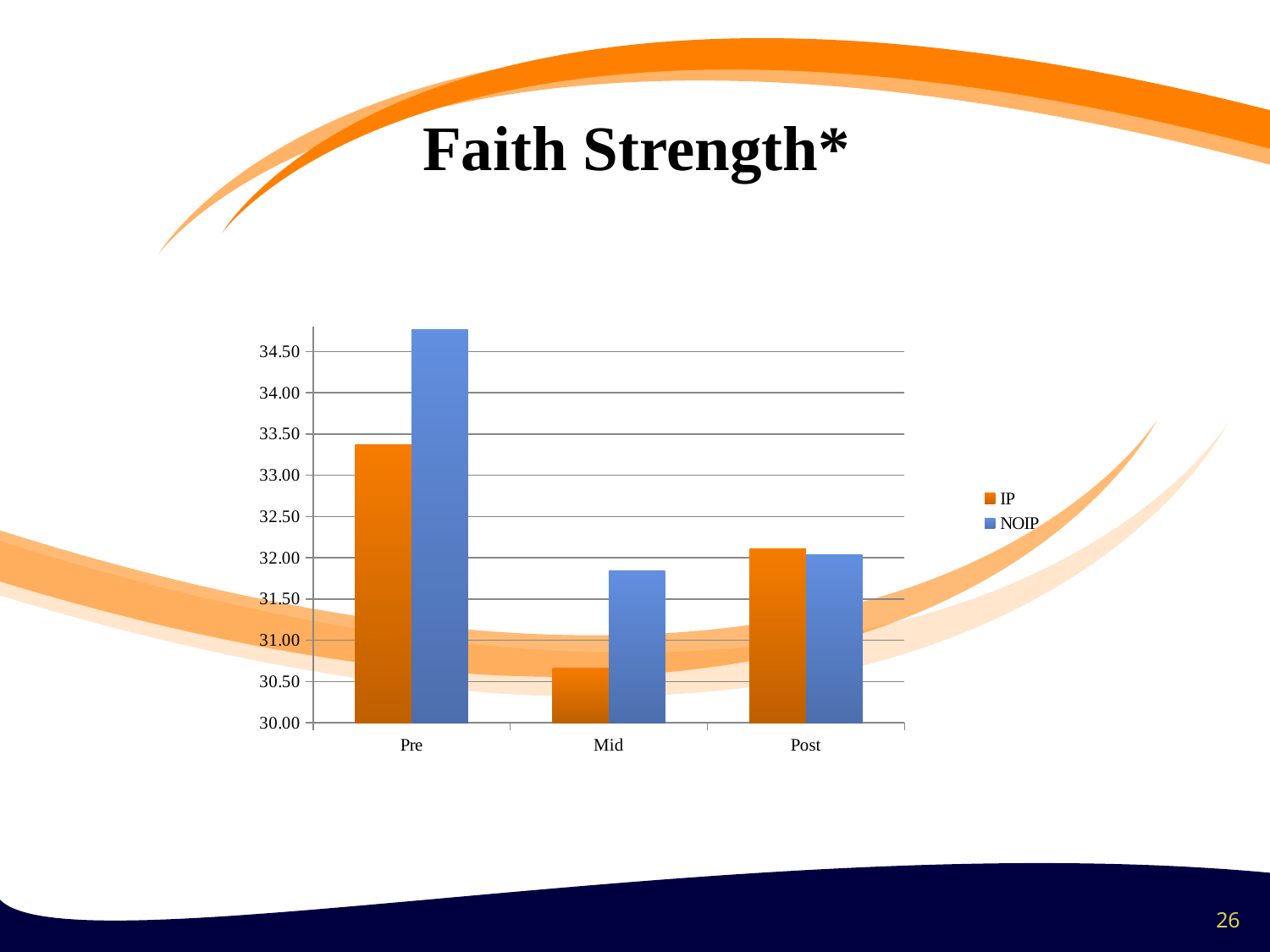
What kind of chart is shown on the slide? Bar chart Is the IP value for Pre greater or less than 33.00? greater Which is larger for Mid, the IP value or the NOIP value? NOIP Which series is shown in blue in the legend? NOIP Is the NOIP value for Pre greater or less than 34.50? greater What is the title of the chart? Faith Strength* How many series does the legend list? 2 For which category is the NOIP bar highest? Pre Does the IP series rise or fall from Pre to Mid? fall How many categories are shown on the x axis? 3 For which category is the IP bar lowest? Mid Is the IP value for Mid greater or less than 31.00? less